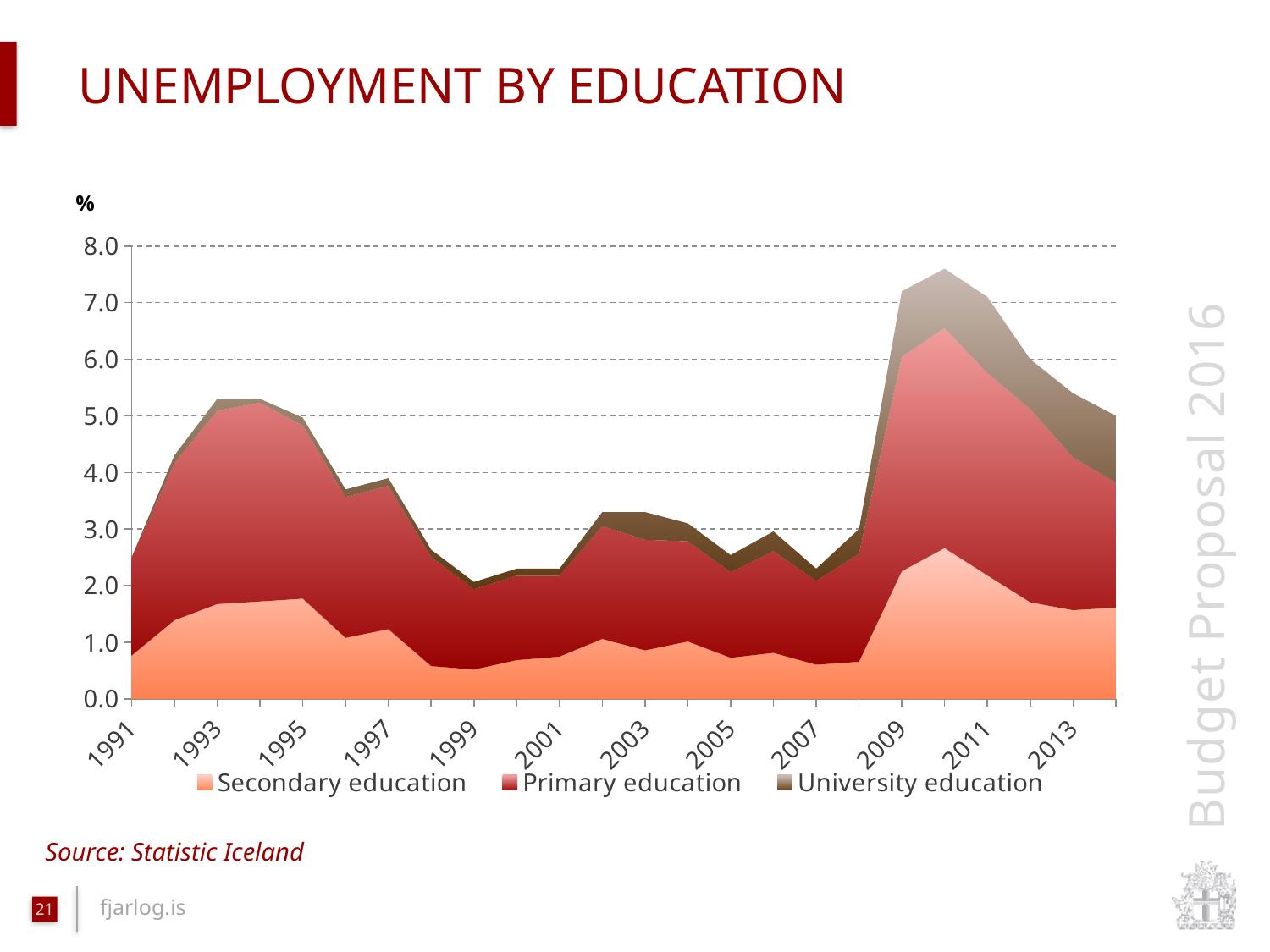
What is the title of the chart? UNEMPLOYMENT BY EDUCATION In which year does the total unemployment across all education levels reach its highest point? 2010 Is the Secondary education value in 2010 greater or less than 2.0? greater How many year labels are shown on the x axis? 12 What kind of chart is shown on the slide? Stacked area chart Which year has the higher total unemployment, 1994 or 2010? 2010 Is the total unemployment in 1991 greater or less than 3.0? less Does the total unemployment rise or fall from 2010 to 2014? fall Is the total unemployment in 1999 greater or less than 3.0? less How many series does the legend list? 3 Which series is plotted as the bottom layer of the stacked area? Secondary education